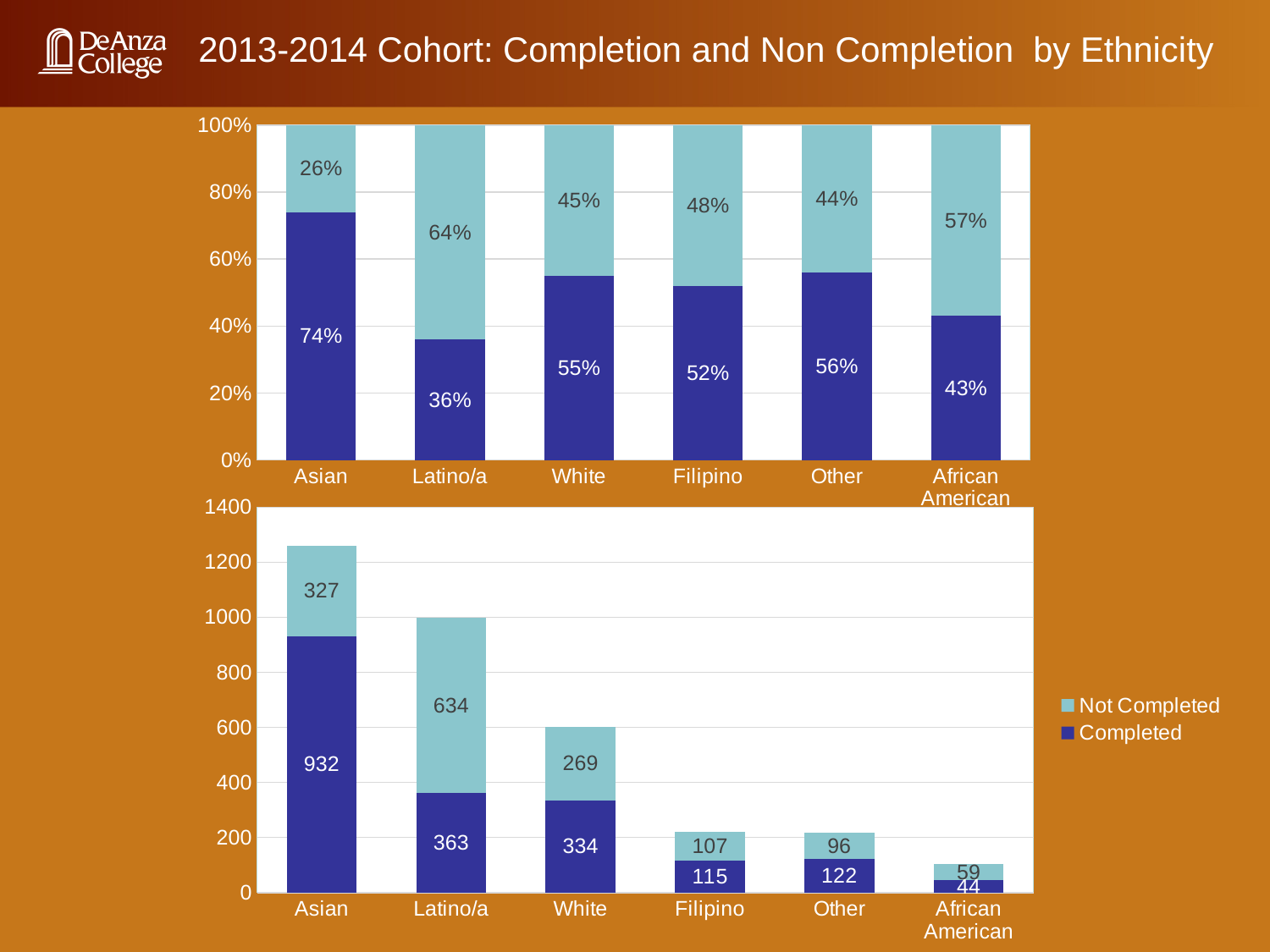
What type of chart is the bottom chart? Stacked bar chart In the top chart, what is the difference between the Completed percentages for White and African American? 12% In the top chart, which ethnicity has the lowest Completed percentage? Latino/a In the bottom chart, how many Latino/a students completed? 363 In the bottom chart, what is the total number of Asian students (Completed plus Not Completed)? 1259 In the top chart, which ethnicity has the highest Completed percentage? Asian How many series does the legend list? 2 In the bottom chart, which ethnicity has the smallest number of Completed students? African American In the bottom chart, is the Completed value for Filipino larger or smaller than the Completed value for Other? smaller In the bottom chart, how many White students did not complete? 269 In the top chart, what is the Not Completed percentage for Latino/a? 64% In the top chart, what percentage of the Asian cohort completed? 74%